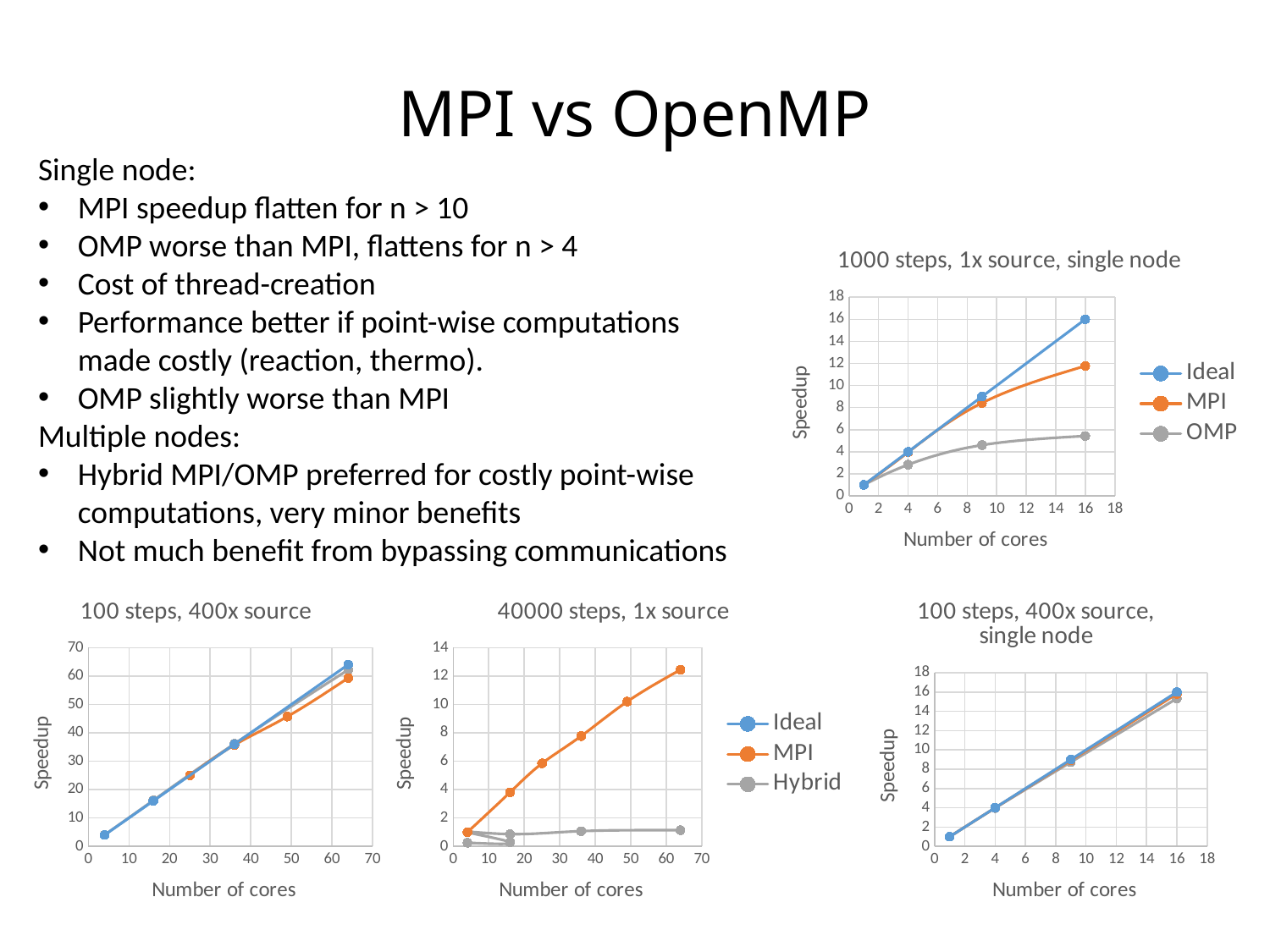
In the chart titled "1000 steps, 1x source, single node", how many series does the legend list? 3 In the chart titled "1000 steps, 1x source, single node", how many data points does the MPI series have? 4 In the chart titled "40000 steps, 1x source", is the Hybrid value at 64 cores greater or less than 2? less In the chart titled "40000 steps, 1x source", is the MPI value at 64 cores greater or less than 10? greater In the chart titled "40000 steps, 1x source", does the MPI speedup rise or fall as the number of cores increases? Rise In the chart titled "1000 steps, 1x source, single node", is the MPI value at 16 cores greater or less than 10? greater In the chart titled "40000 steps, 1x source", which series does the legend list besides Ideal and MPI? Hybrid What is the x-axis label of the chart titled "100 steps, 400x source, single node"? Number of cores What kind of chart is the one titled "1000 steps, 1x source, single node"? Line chart In the chart titled "1000 steps, 1x source, single node", at 16 cores, which series has the larger speedup, MPI or OMP? MPI